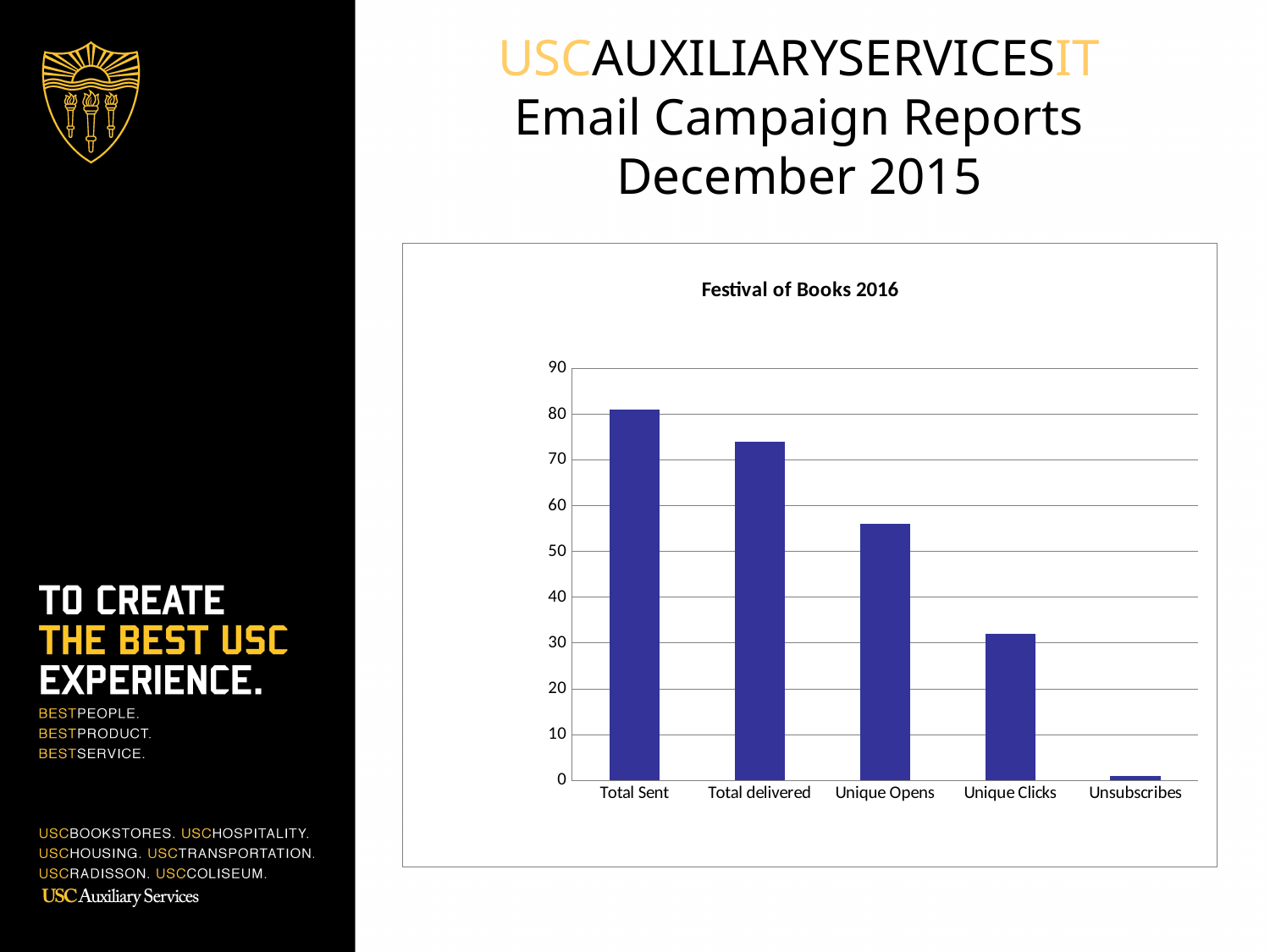
Is the value for Unique Clicks greater or less than 30? greater Which category has the lowest value in the chart? Unsubscribes Do the values rise or fall moving from left to right along the x axis? fall How many categories are plotted on the x axis of the chart? 5 What kind of chart is shown on the slide? bar chart Is the value for Unique Opens greater or less than 60? less Which category has the highest value in the chart? Total Sent Which is larger, the value for Unique Opens or the value for Unique Clicks? Unique Opens What is the title of the chart? Festival of Books 2016 Is the value for Unsubscribes greater or less than 10? less